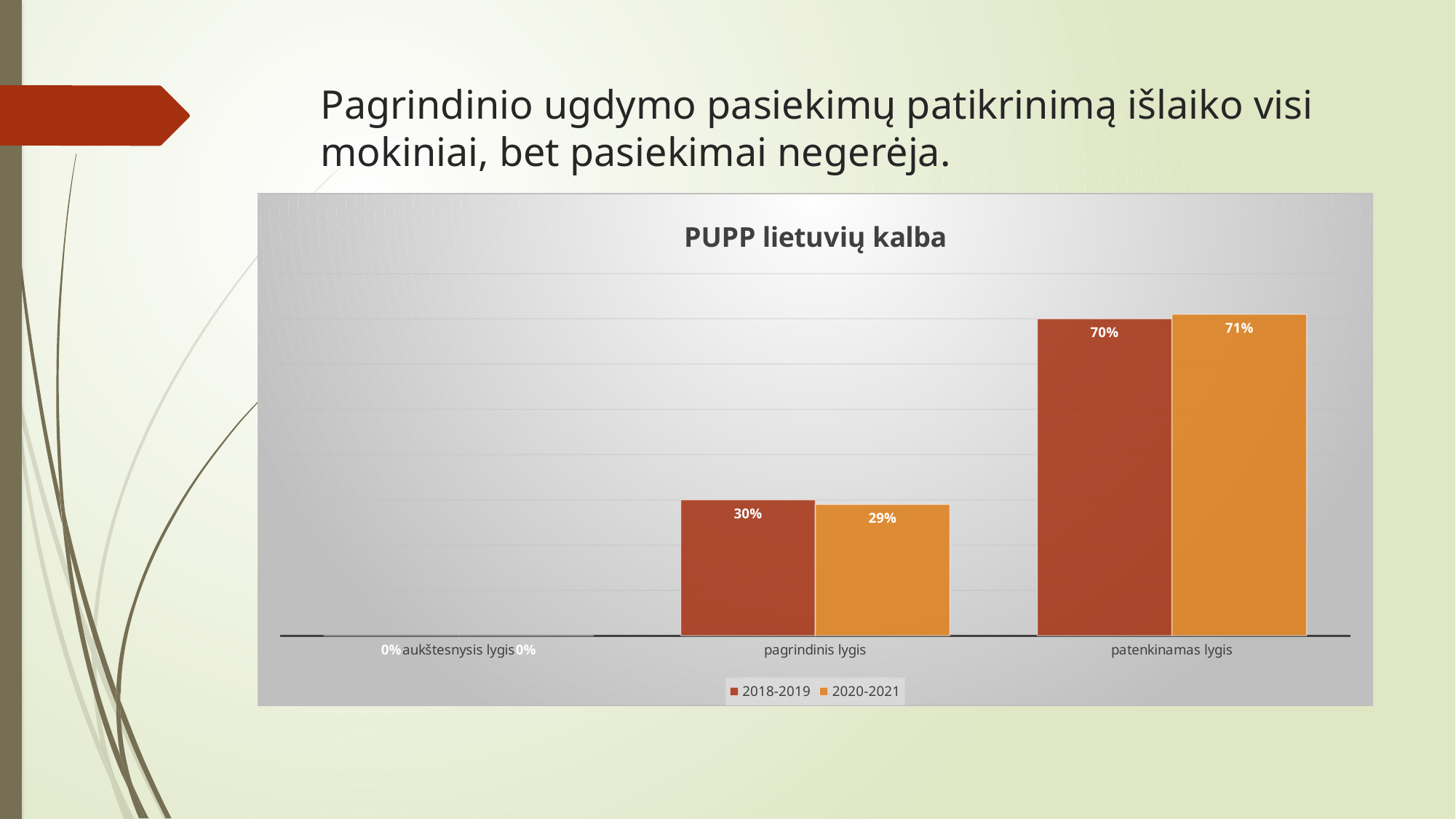
How many categories are shown on the x axis? 3 What is the value for 'patenkinamas lygis' in the 2020-2021 series? 71% What kind of chart is shown on the slide? bar chart What is the difference between the 'patenkinamas lygis' and 'pagrindinis lygis' values in the 2018-2019 series? 40% What is the value for 'pagrindinis lygis' in the 2020-2021 series? 29% What is the difference between the 2018-2019 and 2020-2021 values for 'patenkinamas lygis'? 1% What is the value for 'pagrindinis lygis' in the 2018-2019 series? 30% How many series does the legend list? 2 Which category has the highest value in the 2020-2021 series? patenkinamas lygis Which category has the lowest value in the 2018-2019 series? aukštesnysis lygis What is the value for 'aukštesnysis lygis' in the 2018-2019 series? 0% What is the title of the chart? PUPP lietuvių kalba